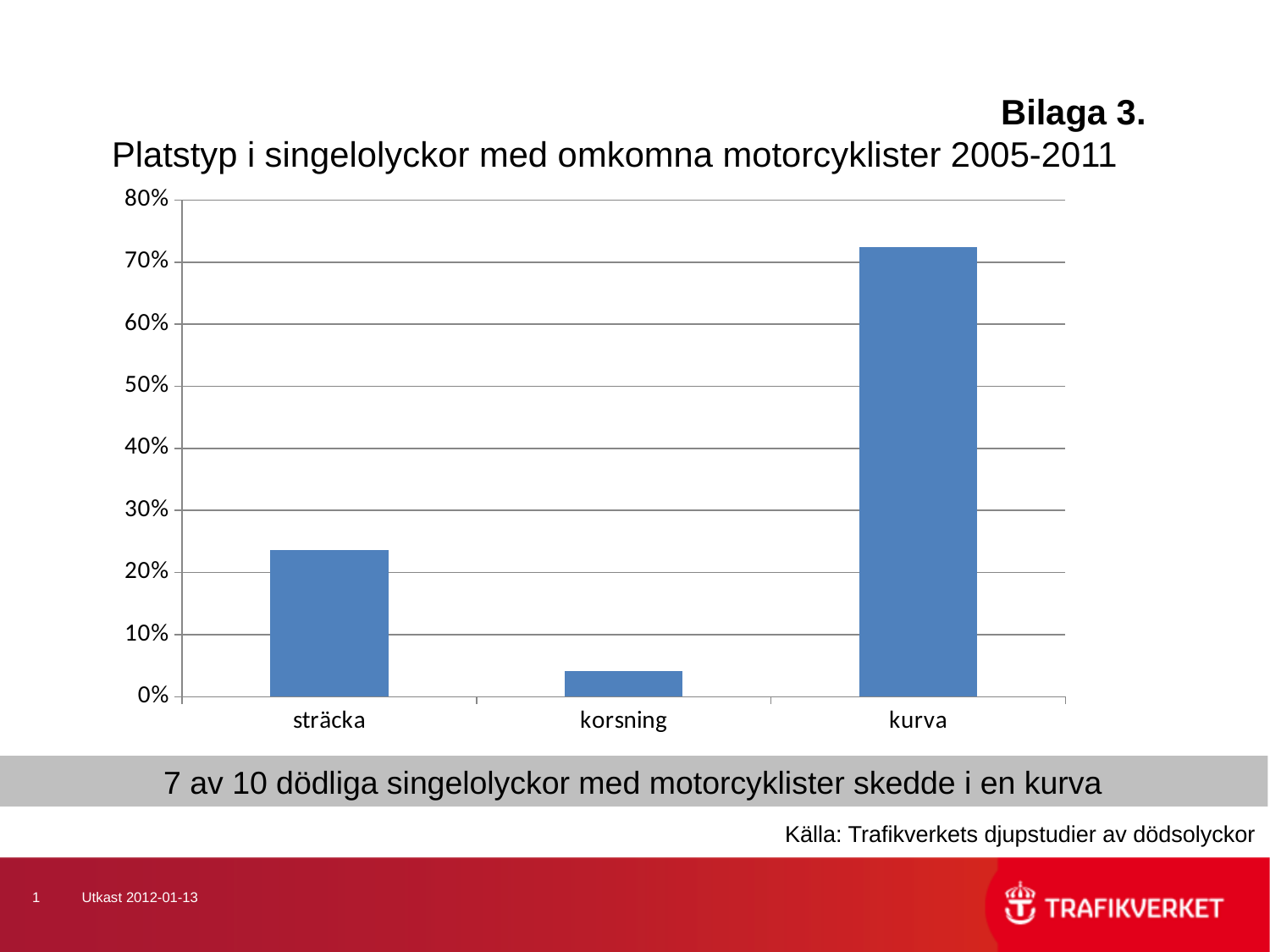
Which is larger, the value for sträcka or the value for korsning? sträcka Is the value for korsning greater or less than 10%? less What is the title of the chart? Platstyp i singelolyckor med omkomna motorcyklister 2005-2011 What kind of chart is shown on the slide? bar chart Is the value for sträcka greater or less than 30%? less What is the highest value shown on the y axis of the chart? 80% Is the value for sträcka greater or less than 20%? greater Which is larger, the value for kurva or the value for sträcka? kurva How many categories are shown on the x axis of the chart? 3 Which category has the lowest value in the chart? korsning Which category has the highest value in the chart? kurva